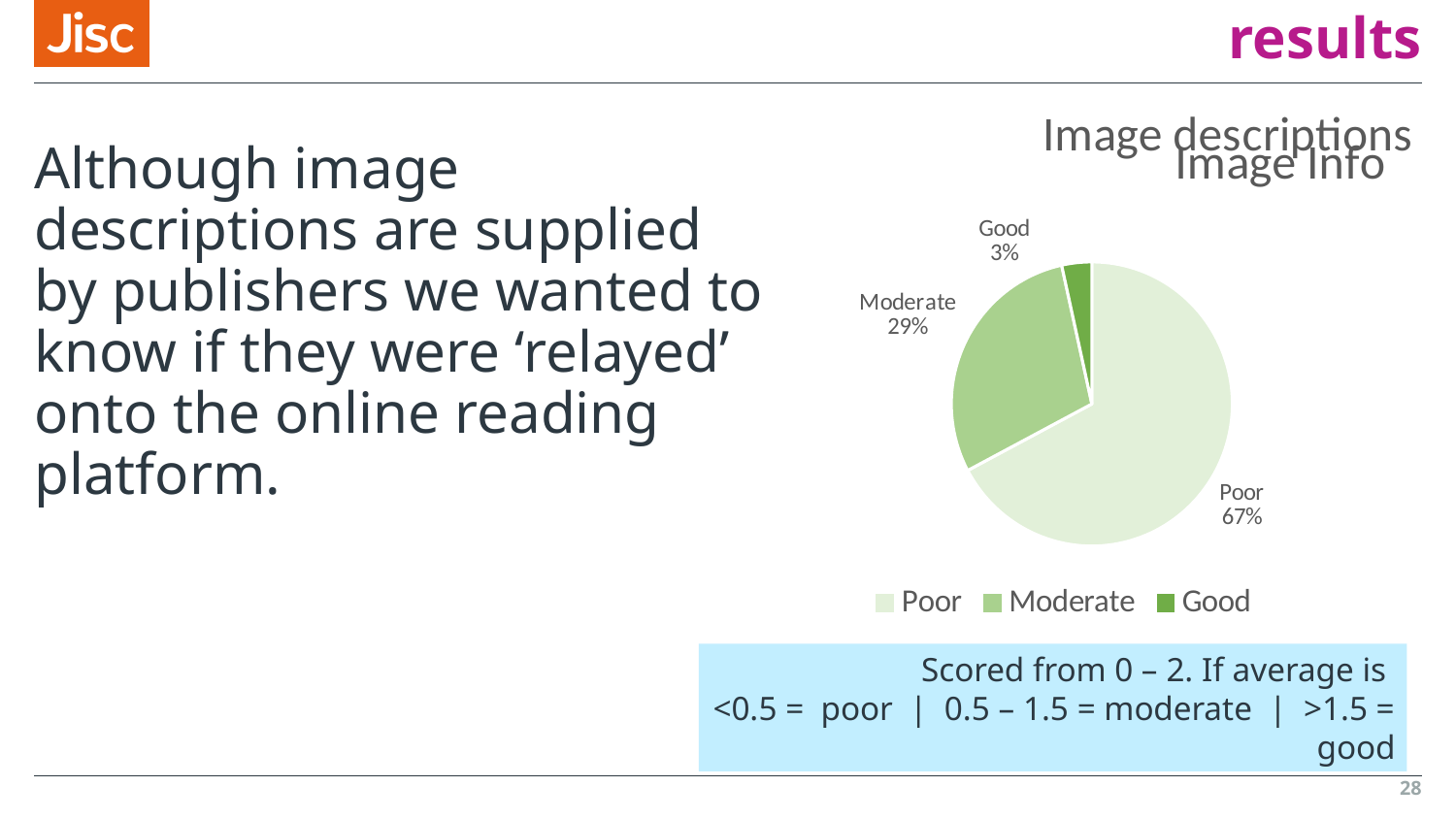
Which category has the largest share of the pie chart? Poor What percentage of the pie chart is labelled Moderate? 29% What is the difference in percentage points between the Moderate and Good slices? 26 Which slice is larger, Moderate or Good? Moderate What percentage of the pie chart is labelled Poor? 67% How many slices does the pie chart have? 3 What is the difference in percentage points between the Poor and Moderate slices? 38 What type of chart is shown on the slide? pie chart What percentage of the pie chart is labelled Good? 3% Which legend entry is shown in the darkest green colour? Good Which category has the smallest share of the pie chart? Good How many entries are listed in the pie chart's legend? 3